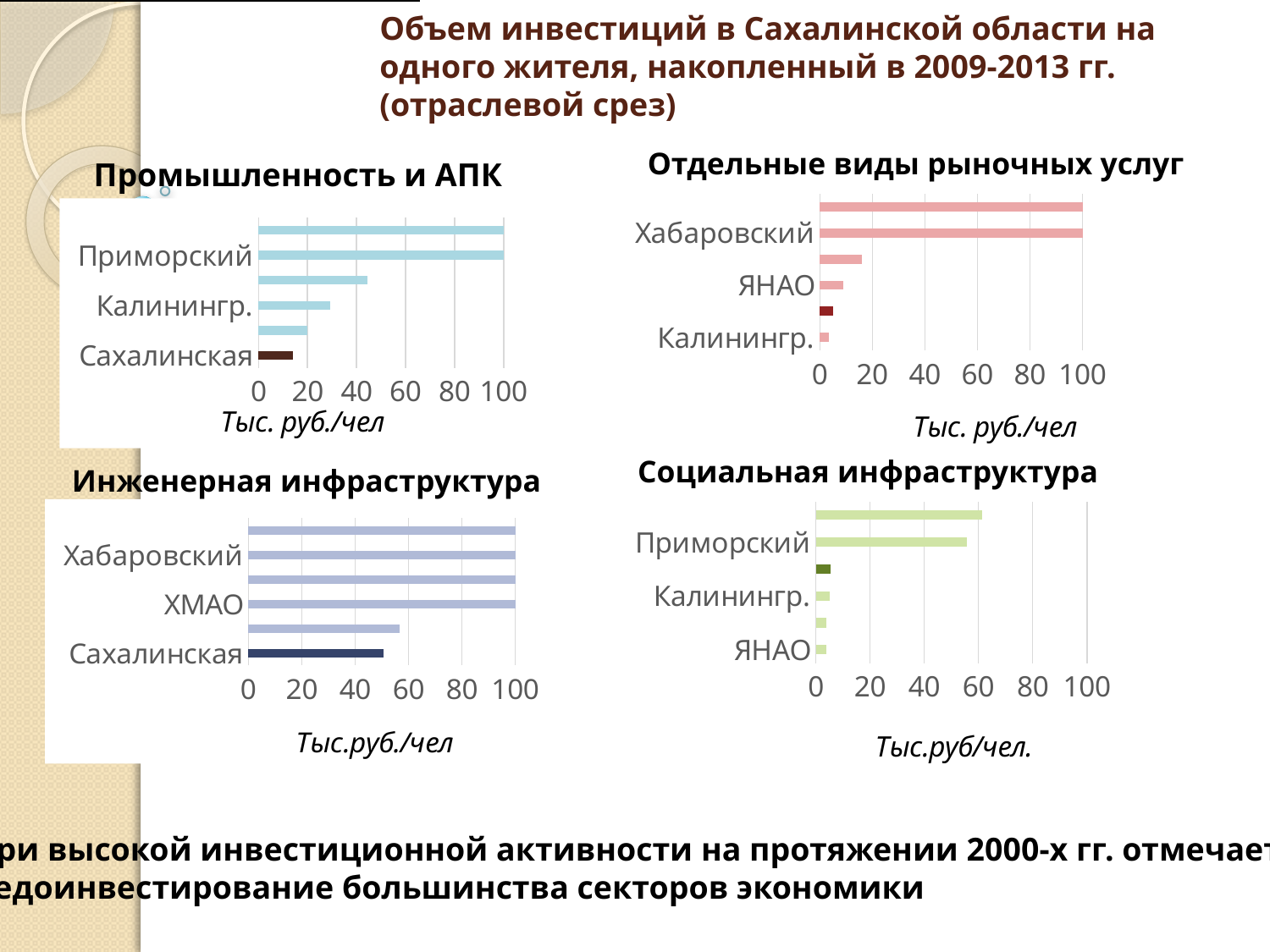
In the 'Инженерная инфраструктура' chart, is the value for Сахалинская greater or less than 60? less How many bars are plotted in the 'Инженерная инфраструктура' chart? 6 In the 'Промышленность и АПК' chart, which is larger, the value for Приморский or the value for Калинингр.? Приморский In the 'Инженерная инфраструктура' chart, which is larger, the value for ХМАО or the value for Сахалинская? ХМАО In the 'Промышленность и АПК' chart, is the value for Сахалинская greater or less than 20? less In the 'Промышленность и АПК' chart, is the value for Приморский greater or less than 80? greater In the 'Социальная инфраструктура' chart, which is larger, the value for Приморский or the value for ЯНАО? Приморский What kind of chart is the 'Промышленность и АПК' chart? bar chart